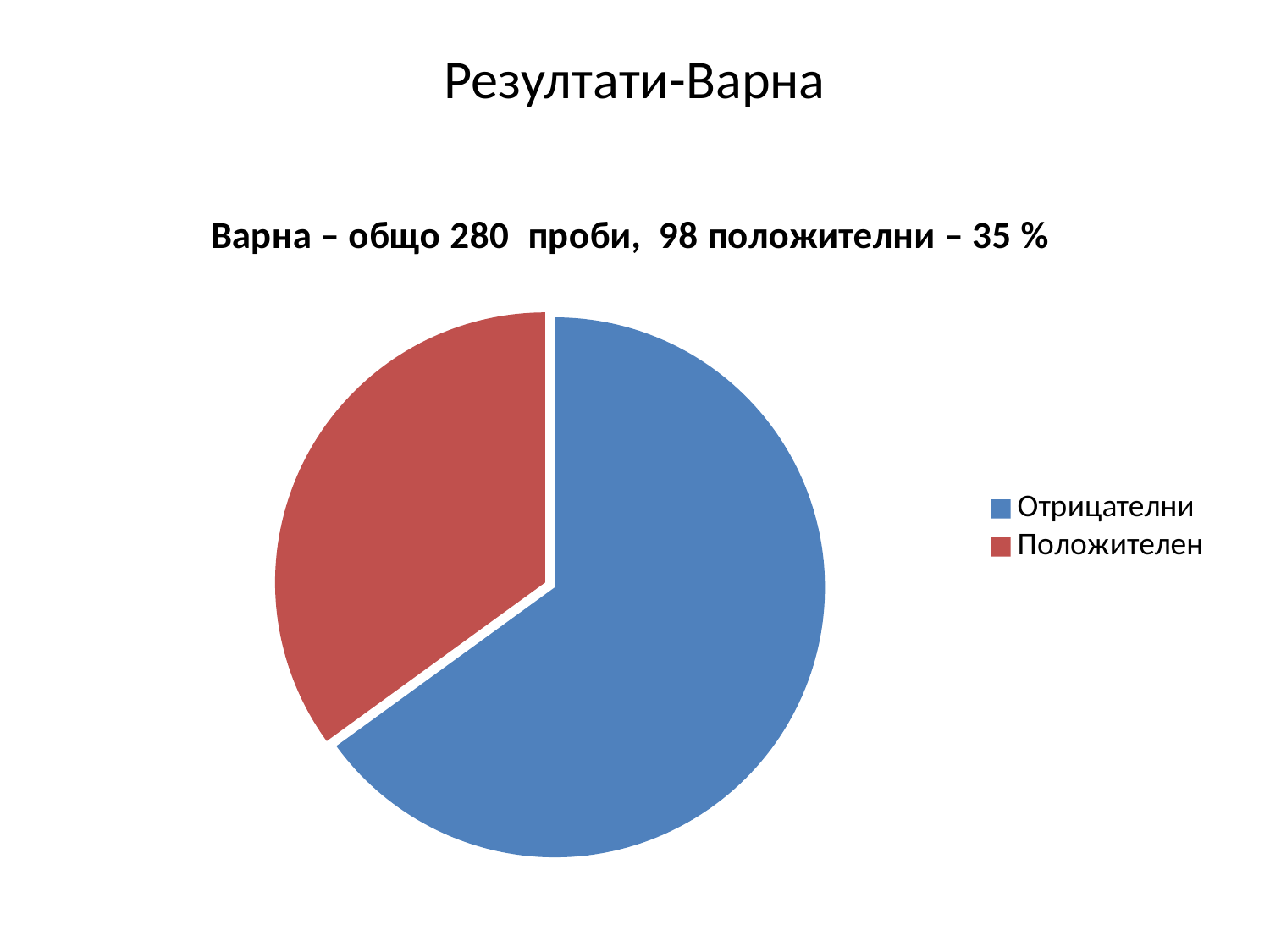
Which category has the largest slice of the pie? Отрицателни According to the chart title, how many samples in total were tested in Варна? 280 What kind of chart is shown on the slide? pie chart According to the chart title, how many samples were positive? 98 What share of the pie do the positive samples (Положителен) represent, according to the chart title? 35 % What is the title of the chart? Варна – общо 280 проби, 98 положителни – 35 % Which slice is larger, Отрицателни or Положителен? Отрицателни How many entries does the legend list? 2 How many slices does the pie chart have? 2 Using the total and positive counts in the chart title, how many samples were negative? 182 Which category has the smallest slice of the pie? Положителен What colour is the Отрицателни slice? blue